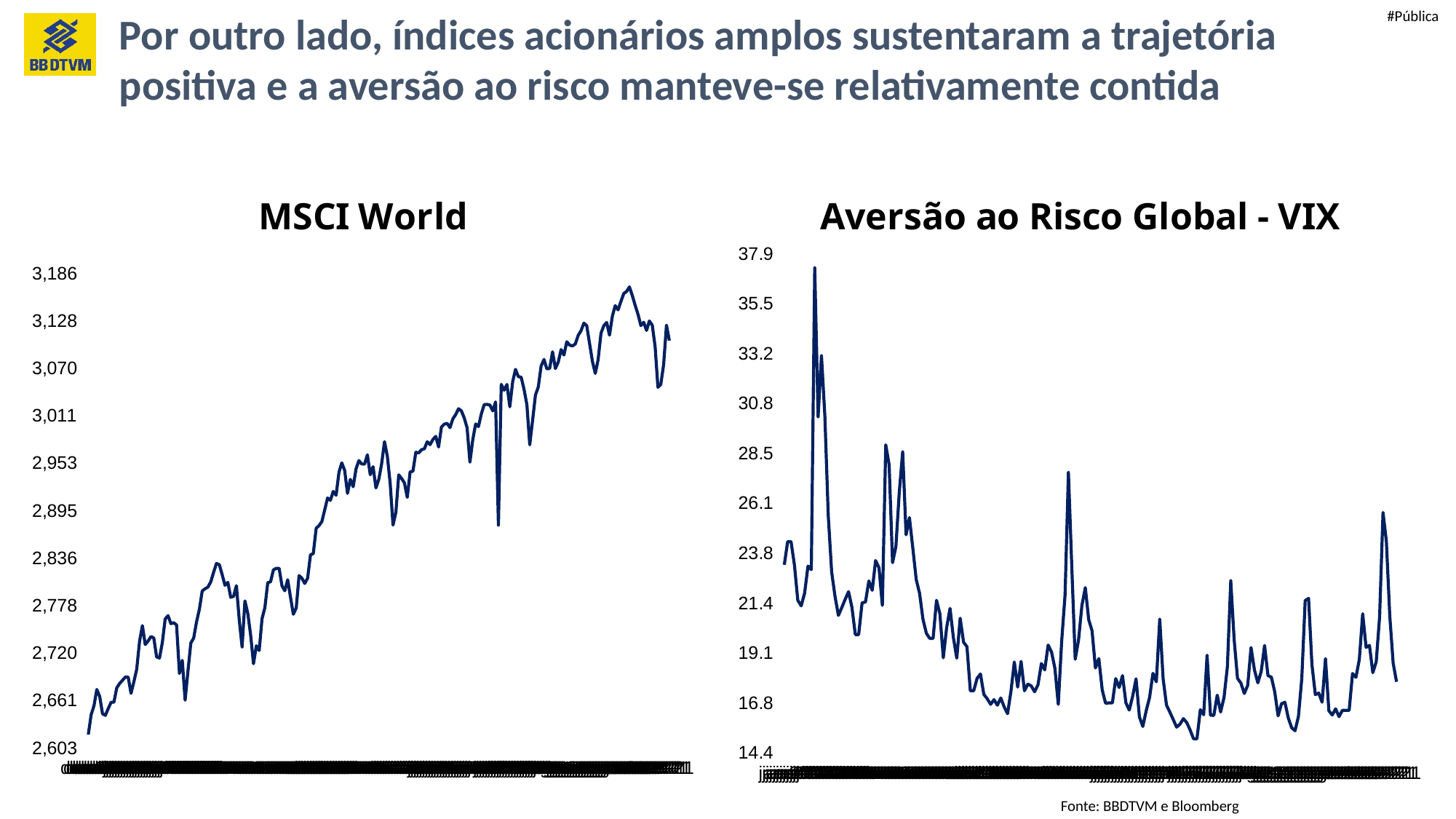
In the MSCI World chart, is the value at the start of the line greater or less than 2,661? less In the Aversão ao Risco Global - VIX chart, do the values overall rise or fall from left to right? fall What kind of chart is the MSCI World chart? line chart In the MSCI World chart, do the values overall rise or fall from left to right? rise In the MSCI World chart, is the value at the end of the line greater or less than 3,070? greater What is the title of the chart on the right side of the slide? Aversão ao Risco Global - VIX In the MSCI World chart, is the highest point of the line greater or less than 3,128? greater What kind of chart is the Aversão ao Risco Global - VIX chart? line chart How many charts are shown on the slide? 2